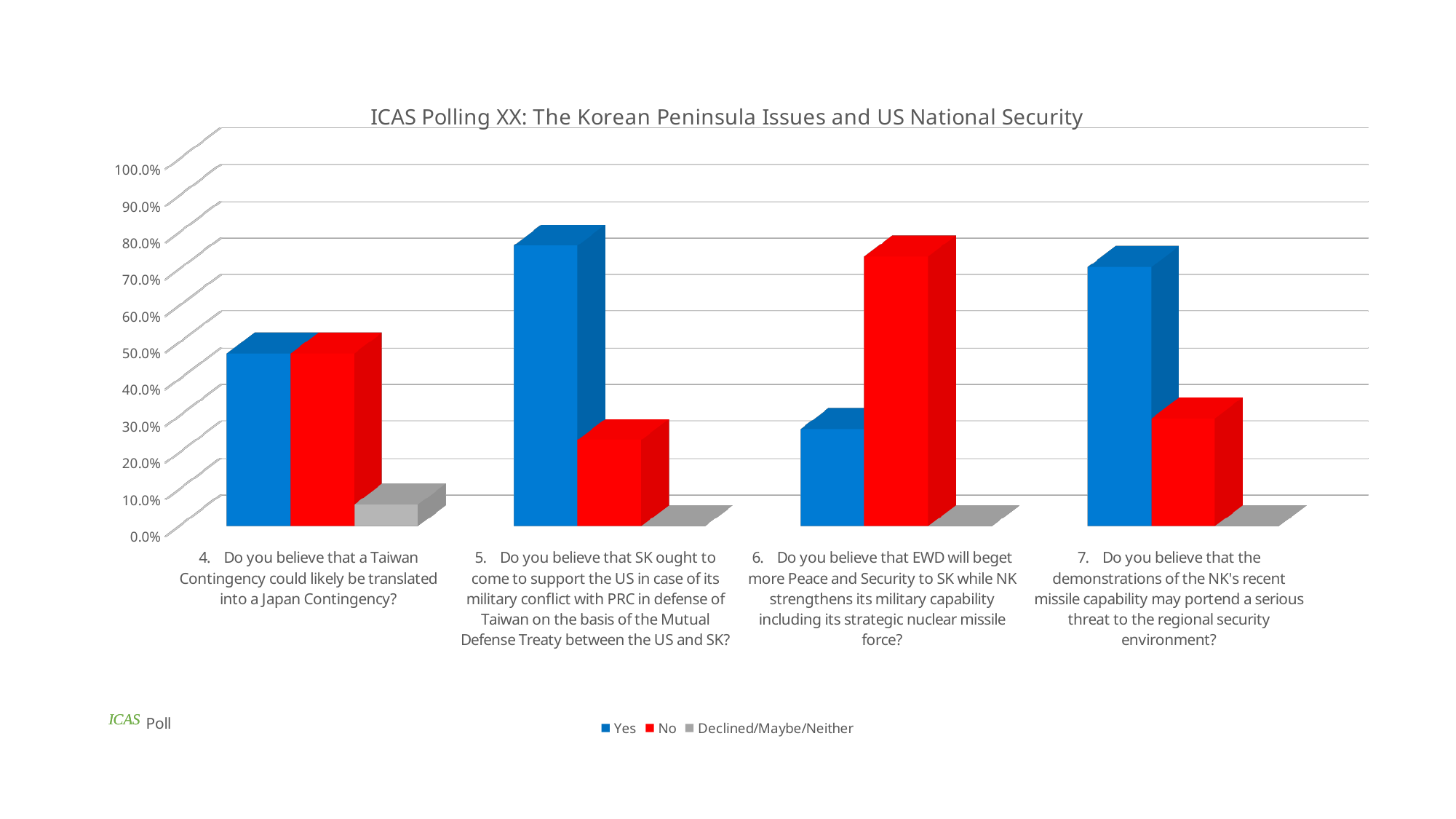
For question 5 (SK supporting the US in a conflict with PRC), which is larger, Yes or No? Yes What kind of chart is shown on the slide? Bar chart For question 7 (NK's recent missile capability as a serious threat), which is larger, Yes or No? Yes For question 6 (EWD begetting more Peace and Security to SK), which is larger, Yes or No? No Which colour represents the "No" series in the legend? Red How many survey questions (categories) are plotted on the x axis? 4 Is the "No" value for question 7 greater or less than 40.0%? less Which survey question has the lowest "Yes" value? 6. Do you believe that EWD will beget more Peace and Security to SK while NK strengthens its military capability including its strategic nuclear missile force? How many series does the legend list? 3 Which survey question has the highest "No" value? 6. Do you believe that EWD will beget more Peace and Security to SK while NK strengthens its military capability including its strategic nuclear missile force? What is the title of the chart? ICAS Polling XX: The Korean Peninsula Issues and US National Security Is the "Yes" value for question 5 greater or less than 70.0%? greater